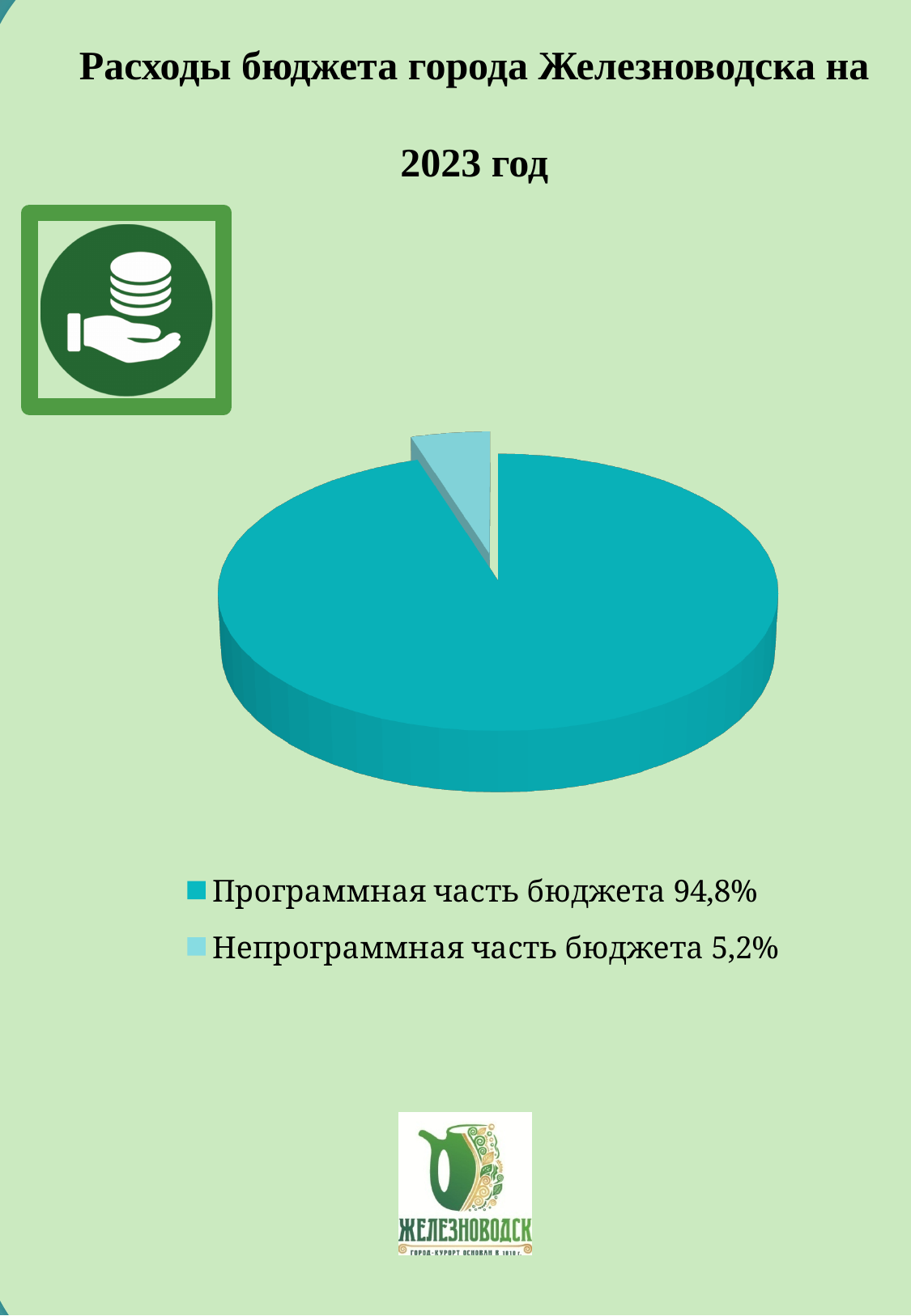
Which slice of the pie is the smallest? Непрограммная часть бюджета What share of the budget expenditure is the programme part (Программная часть бюджета)? 94,8% What is the difference in percentage points between the programme part and the non-programme part of the budget? 89,6 How many entries does the legend list? 2 How many slices does the pie chart have? 2 Which is larger: the programme part or the non-programme part of the budget? Программная часть бюджета What share of the budget expenditure is the non-programme part (Непрограммная часть бюджета)? 5,2% What kind of chart is shown on the slide? Pie chart Which slice of the pie is the largest? Программная часть бюджета What is the title of the slide containing the chart? Расходы бюджета города Железноводска на 2023 год Which legend entry is shown in the lighter blue colour? Непрограммная часть бюджета 5,2%